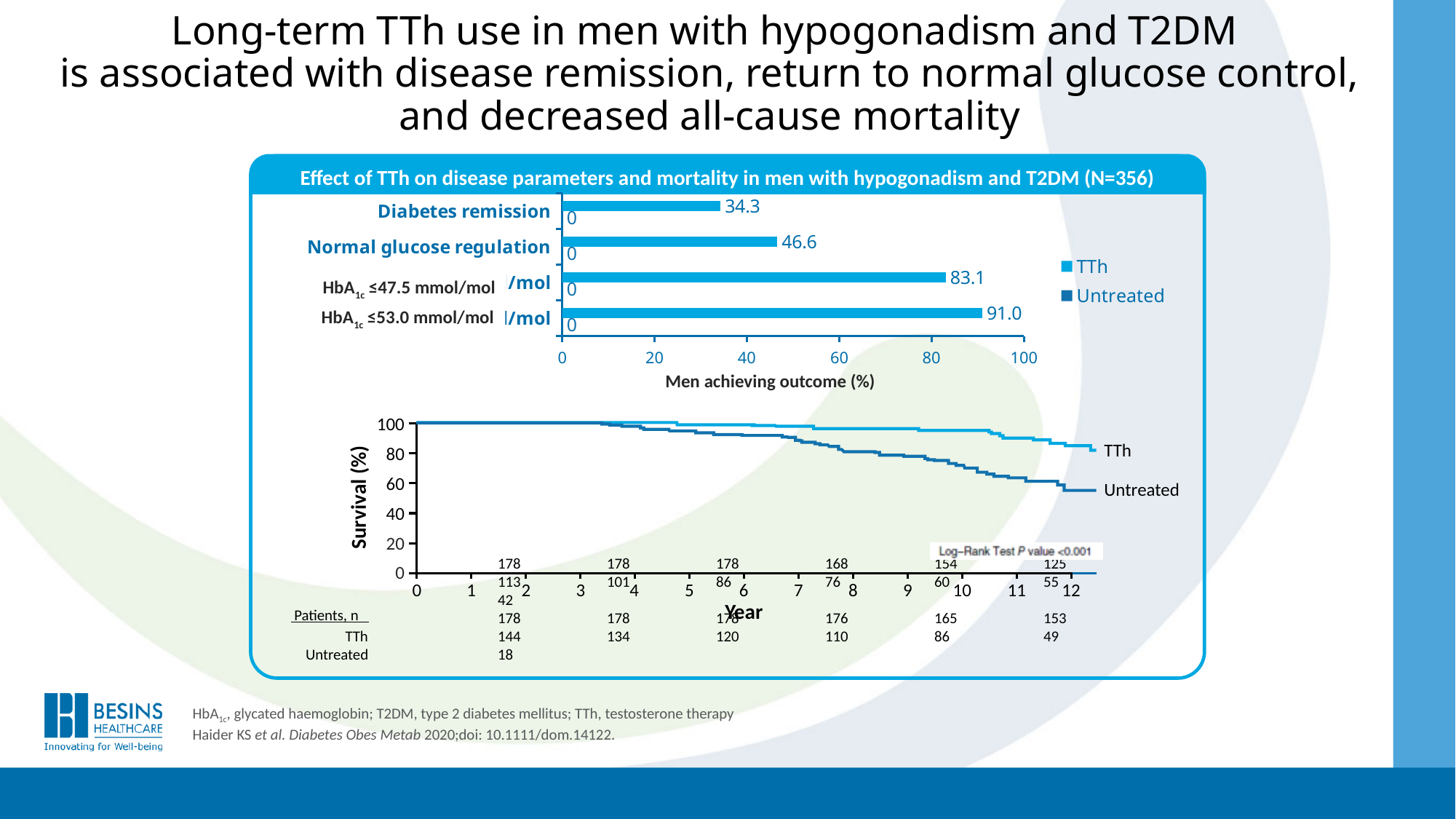
In the survival chart, is the Untreated survival at year 12 greater or less than 60%? less In the bar chart, what is the Untreated value for Normal glucose regulation? 0 How many series does the legend of the bar chart list? 2 What kind of chart is the top chart on the slide? Bar chart How many outcome categories are shown in the bar chart? 4 In the bar chart, which outcome has the lowest TTh value? Diabetes remission In the survival chart, does the Untreated survival curve rise or fall over the years? Fall In the bar chart, which has a larger TTh value: Normal glucose regulation or Diabetes remission? Normal glucose regulation In the bar chart, what is the TTh value for HbA1c ≤53.0 mmol/mol? 91.0 In the bar chart, which outcome has the highest TTh value? HbA1c ≤53.0 mmol/mol In the bar chart, what is the difference between the TTh values for HbA1c ≤53.0 mmol/mol and HbA1c ≤47.5 mmol/mol? 7.9 In the bar chart, what percentage of TTh-treated men achieved diabetes remission? 34.3